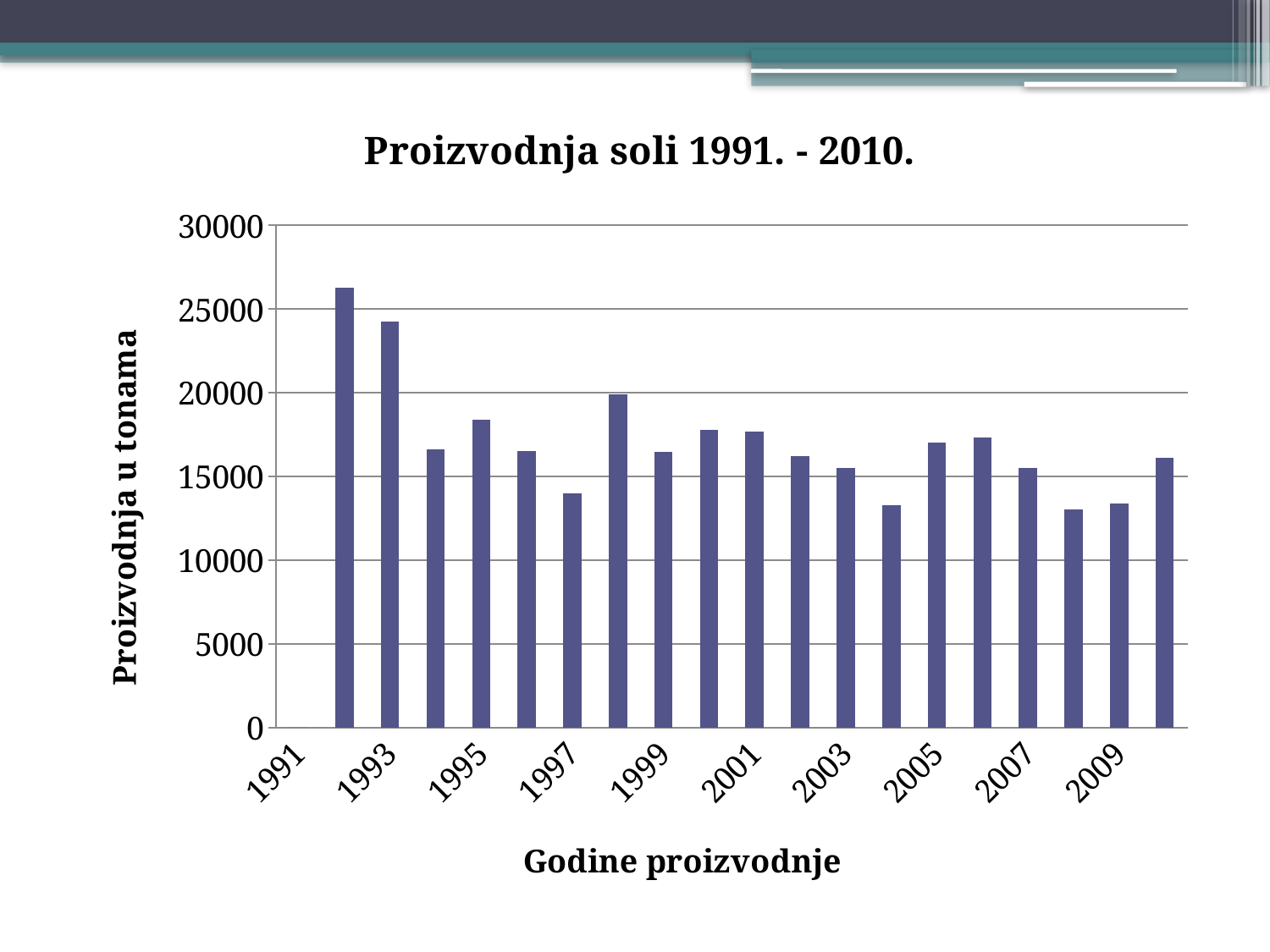
Which year has the larger value, 1993 or 1995? 1993 Is the value for 1993 greater or less than 20000? greater What is the label of the vertical axis? Proizvodnja u tonama Is the value for 1995 greater or less than 15000? greater Is the value for 1997 greater or less than 15000? less Which year has the larger value, 2005 or 2009? 2005 What is the title of the chart? Proizvodnja soli 1991. - 2010. Which year has the larger value, 1997 or 1999? 1999 Overall, do the values rise or fall from 1993 to 2009? fall What type of chart is shown on the slide? bar chart